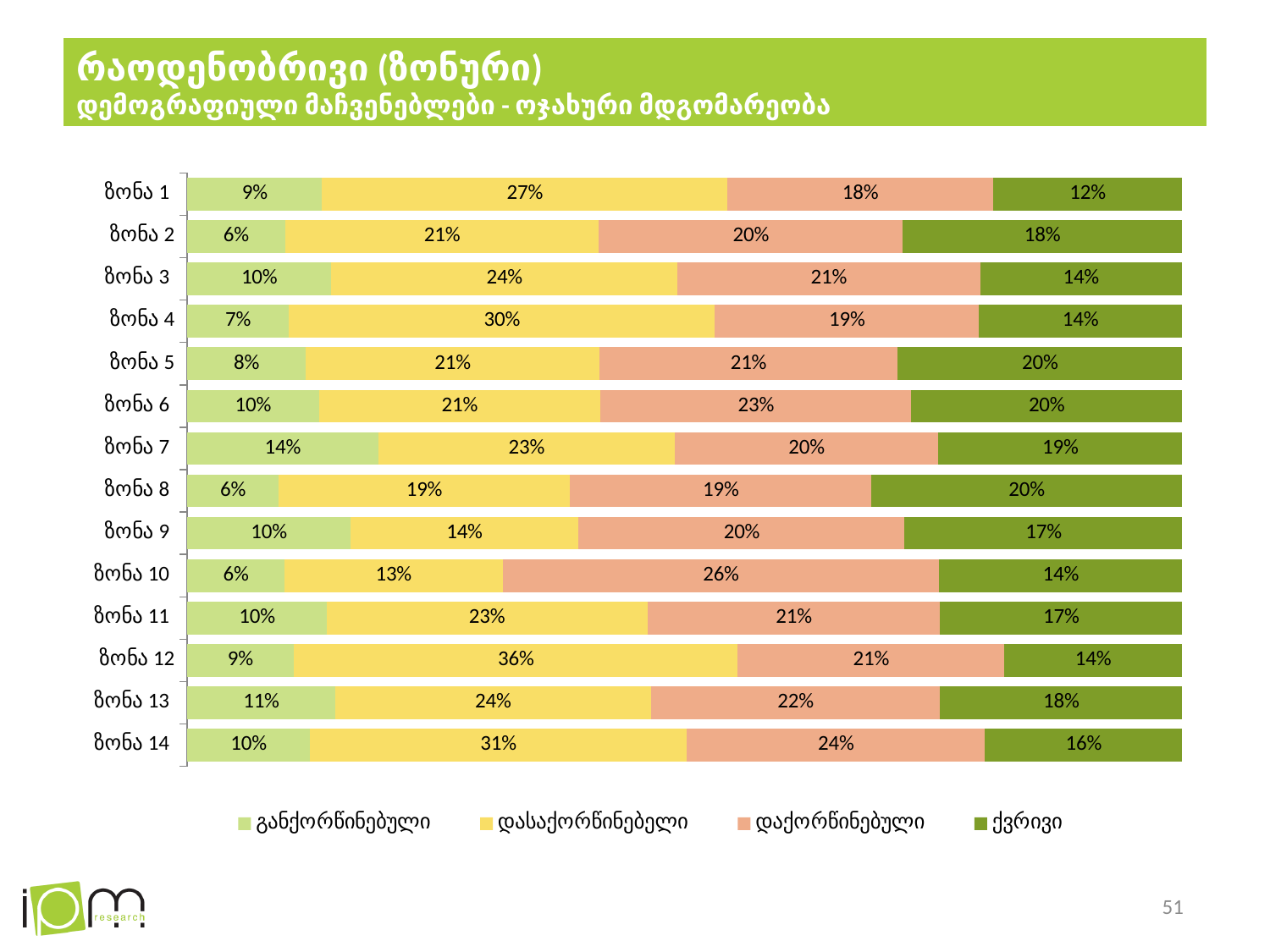
What is the value for დასაქორწინებელი in ზონა 12? 36% Which is larger: the ქვრივი value for ზონა 2 or for ზონა 1? ზონა 2 How many zones are shown on the chart? 14 What is the value for დაქორწინებული in ზონა 10? 26% How many series does the legend list? 4 What kind of chart is shown on the slide? Stacked bar chart Which zone has the highest value for დასაქორწინებელი? ზონა 12 Which legend entry is shown in dark green? ქვრივი What is the difference between the დასაქორწინებელი values for ზონა 14 and ზონა 9? 17% What is the value for განქორწინებული in ზონა 7? 14% Which zone has the lowest value for დასაქორწინებელი? ზონა 10 What is the value for ქვრივი in ზონა 8? 20%